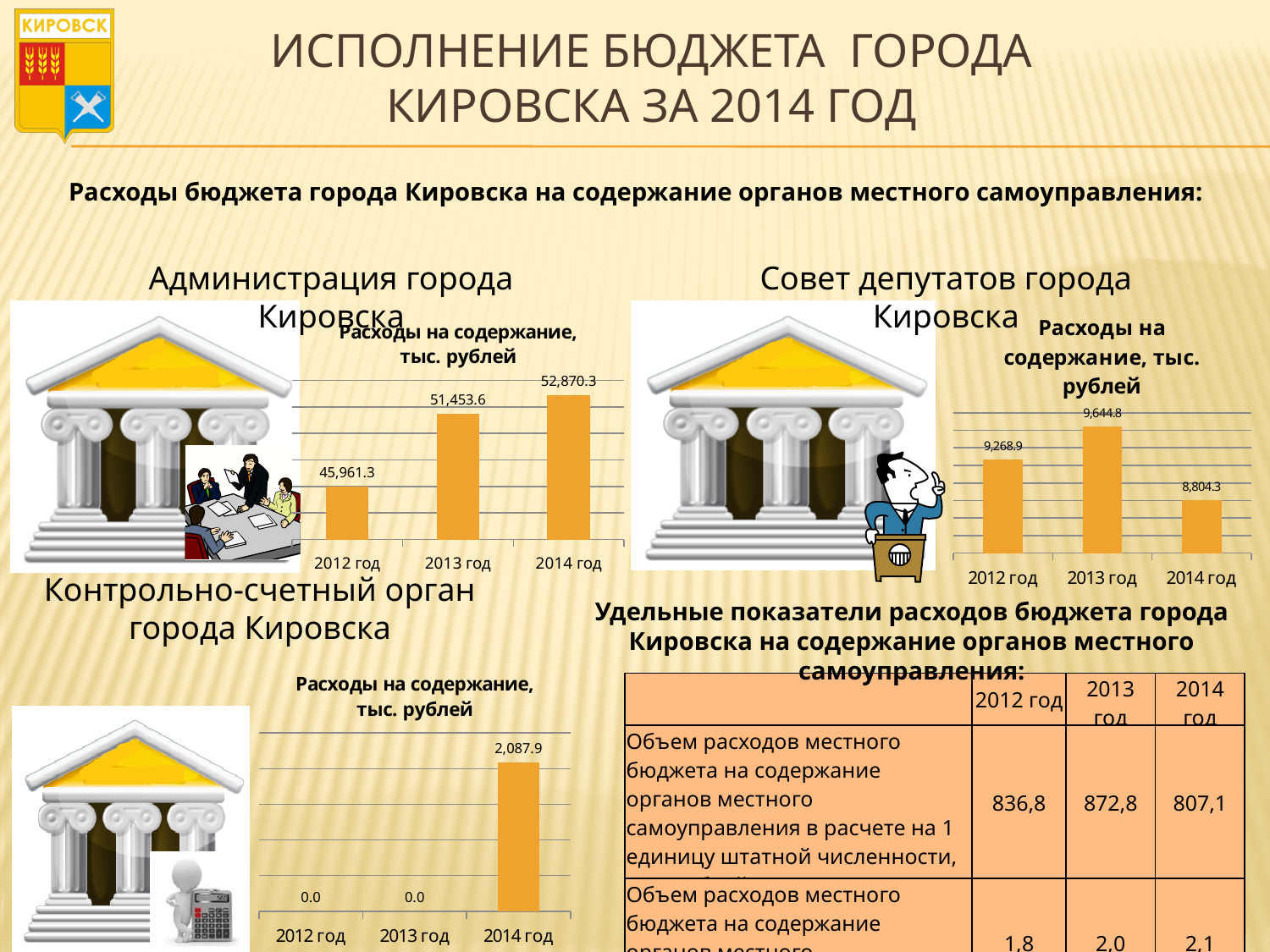
In the Контрольно-счетный орган города Кировска chart, what is the value for 2014 год? 2,087.9 In the Администрация города Кировска chart, what is the value for 2014 год? 52,870.3 In the Администрация города Кировска chart, do the values rise or fall from 2012 год to 2014 год? rise In the Совет депутатов города Кировска chart, what is the difference between the 2013 год and 2014 год values? 840.5 In the Совет депутатов города Кировска chart, what is the value for 2013 год? 9,644.8 In the Администрация города Кировска chart, what is the difference between the 2013 год and 2012 год values? 5,492.3 How many years are shown on the x axis of the Контрольно-счетный орган города Кировска chart? 3 In the Совет депутатов города Кировска chart, which is larger, the value for 2012 год or 2014 год? 2012 год In the Совет депутатов города Кировска chart, which year has the highest value? 2013 год In the Администрация города Кировска chart, which year has the lowest value? 2012 год What type of chart is used for the Администрация города Кировска data? bar chart In the Администрация города Кировска chart, what is the value for 2012 год? 45,961.3